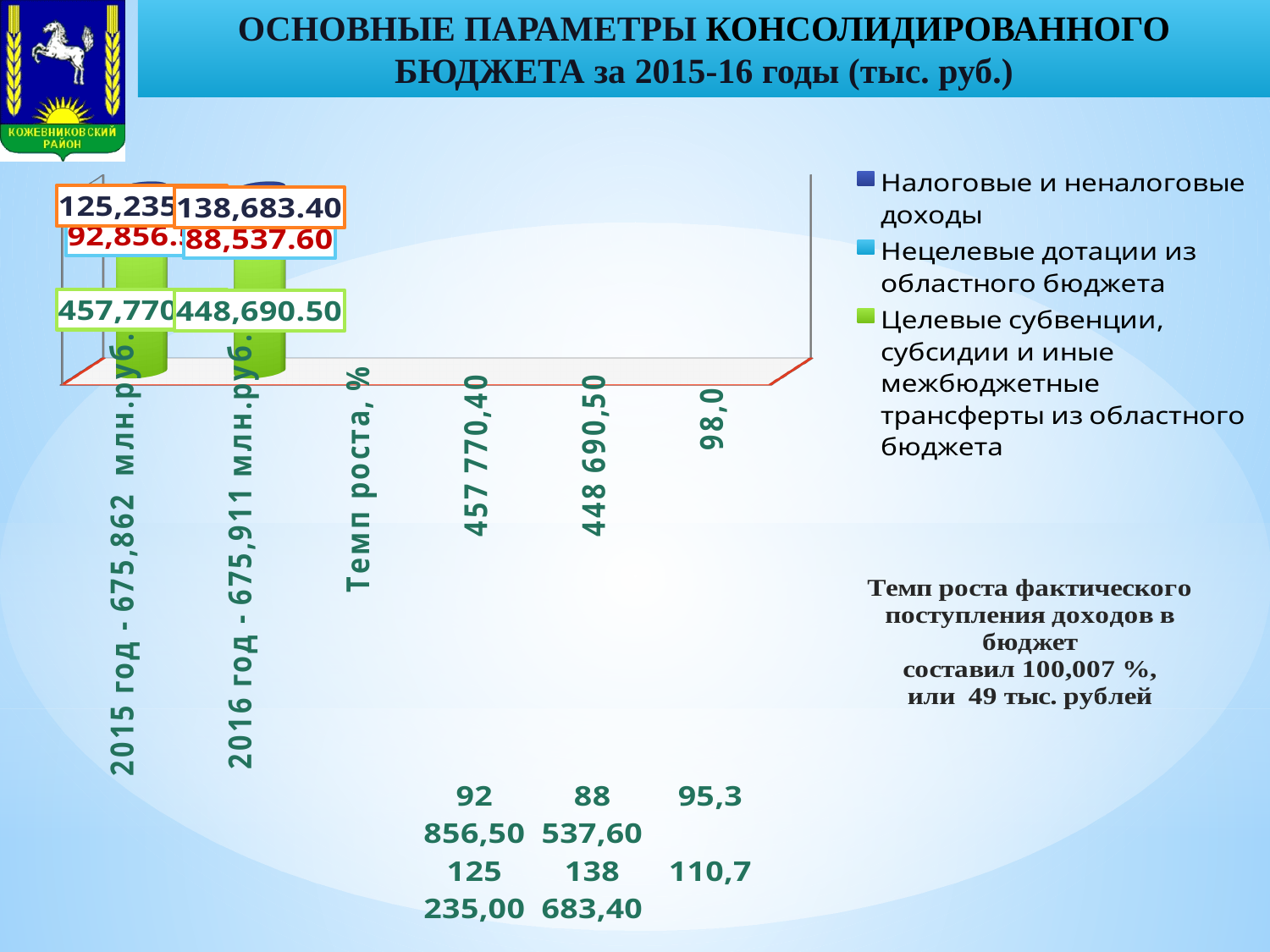
What is the value of Налоговые и неналоговые доходы for 2016? 138,683.40 What is the value of Нецелевые дотации из областного бюджета for 2016? 88,537.60 What is the value of Налоговые и неналоговые доходы for 2015? 125,235 How many series does the chart legend list? 3 Which year has the larger value for Целевые субвенции, субсидии и иные межбюджетные трансферты, 2015 or 2016? 2015 What colour represents Целевые субвенции, субсидии и иные межбюджетные трансферты in the legend? green Which series has the highest value in the 2016 bar? Целевые субвенции, субсидии и иные межбюджетные трансферты из областного бюджета How many bars are plotted in the chart? 2 Which year has the larger value for Налоговые и неналоговые доходы, 2015 or 2016? 2016 What is the difference between Целевые субвенции (448,690.50) and Нецелевые дотации (88,537.60) for 2016? 360,152.90 What kind of chart is shown on the slide? bar chart What is the value of Целевые субвенции, субсидии и иные межбюджетные трансферты из областного бюджета for 2016? 448,690.50